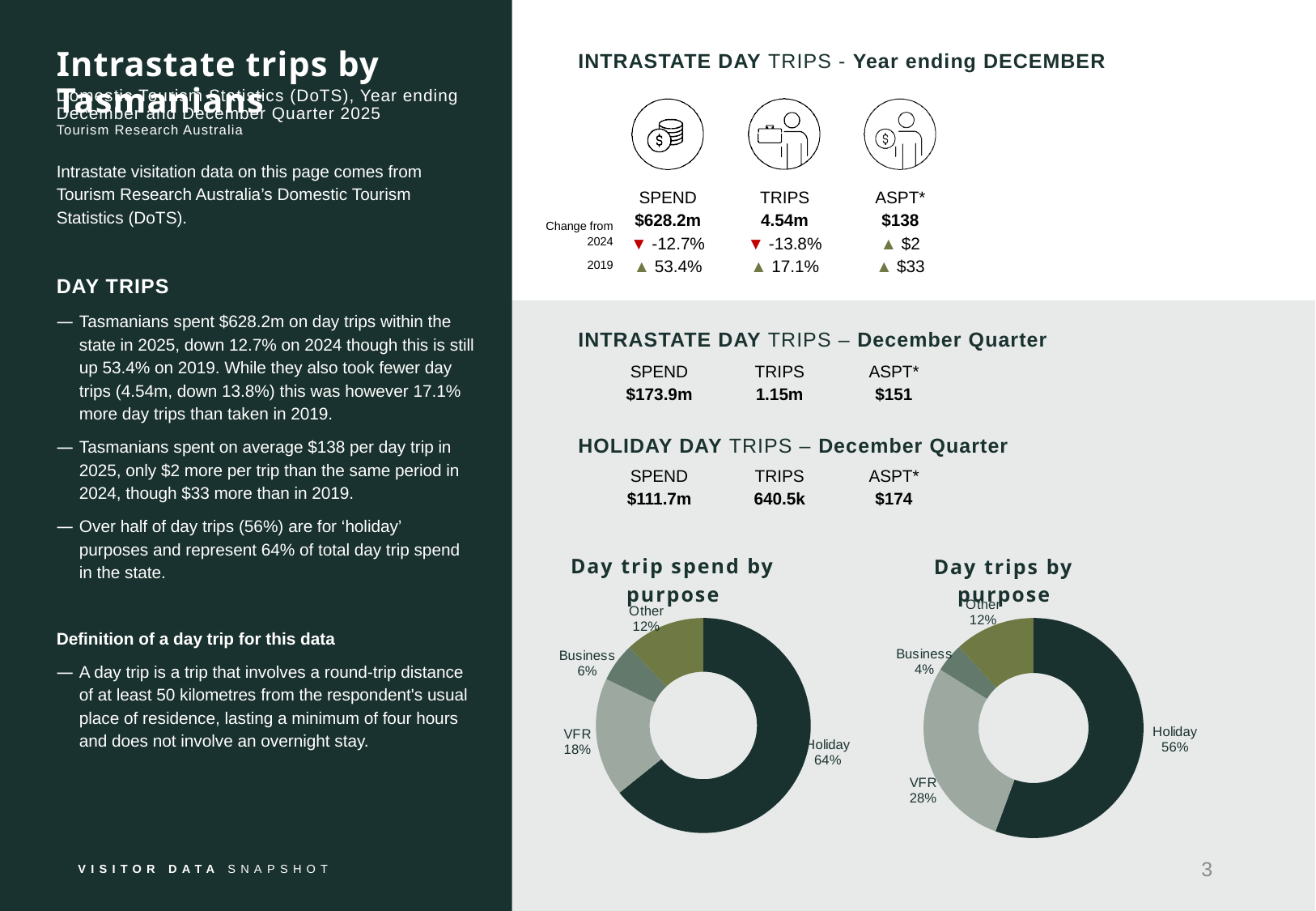
In the 'Day trip spend by purpose' chart, what share of spend is for VFR? 18% In the 'Day trip spend by purpose' chart, which purpose has the largest share? Holiday In the 'Day trip spend by purpose' chart, what share of spend is for Holiday? 64% In the 'Day trips by purpose' chart, what share of trips is for Business? 4% What is the title of the chart on the right side of the slide? Day trips by purpose In the 'Day trips by purpose' chart, which purpose has the smallest share? Business In the 'Day trip spend by purpose' chart, which purpose has the smallest share? Business How many purpose categories are shown in the 'Day trips by purpose' chart? 4 What type of chart is 'Day trip spend by purpose'? Donut (pie) chart In the 'Day trip spend by purpose' chart, which is larger: the Other share or the Business share? Other In the 'Day trips by purpose' chart, what is the difference between the Holiday and VFR shares? 28% In the 'Day trips by purpose' chart, what share of trips is for VFR? 28%